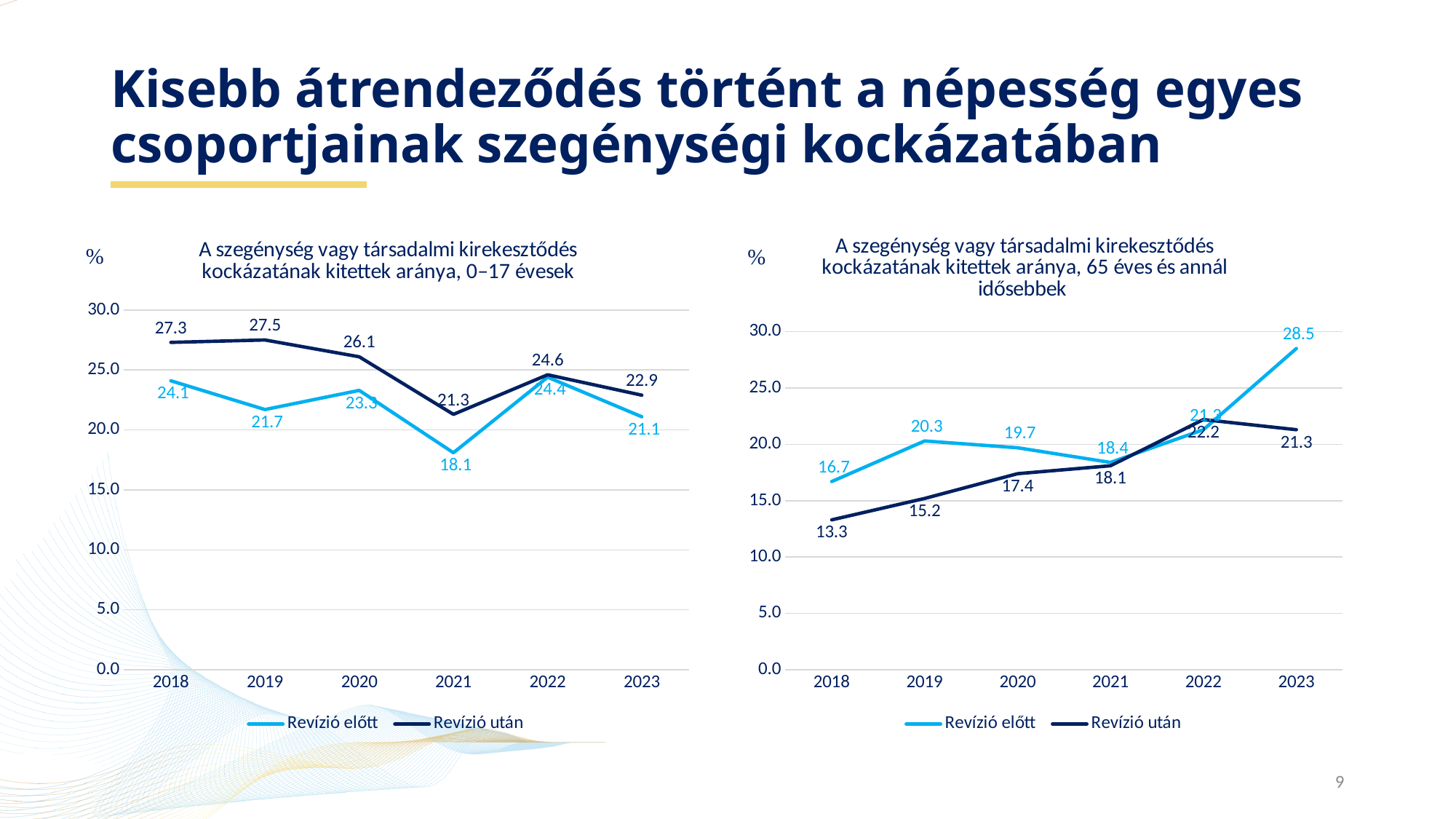
In the right chart (65 éves és annál idősebbek), does the Revízió után line generally rise or fall from 2018 to 2022? rise In the left chart (0–17 évesek), which year has the lowest Revízió előtt value? 2021 What type of chart is the right chart (65 éves és annál idősebbek)? line chart In the left chart (0–17 évesek), what is the difference between Revízió után and Revízió előtt in 2018? 3.2 In the left chart (0–17 évesek), what is the value of Revízió után in 2019? 27.5 In the right chart (65 éves és annál idősebbek), what is the value of Revízió előtt in 2023? 28.5 In the left chart (0–17 évesek), which is larger in 2023: Revízió előtt or Revízió után? Revízió után In the right chart (65 éves és annál idősebbek), what is the difference between Revízió előtt and Revízió után in 2019? 5.1 In the right chart (65 éves és annál idősebbek), which year has the highest Revízió után value? 2022 In the right chart (65 éves és annál idősebbek), what is the value of Revízió után in 2018? 13.3 How many years are shown on the x axis of the left chart (0–17 évesek)? 6 In the left chart (0–17 évesek), what is the value of Revízió előtt in 2021? 18.1